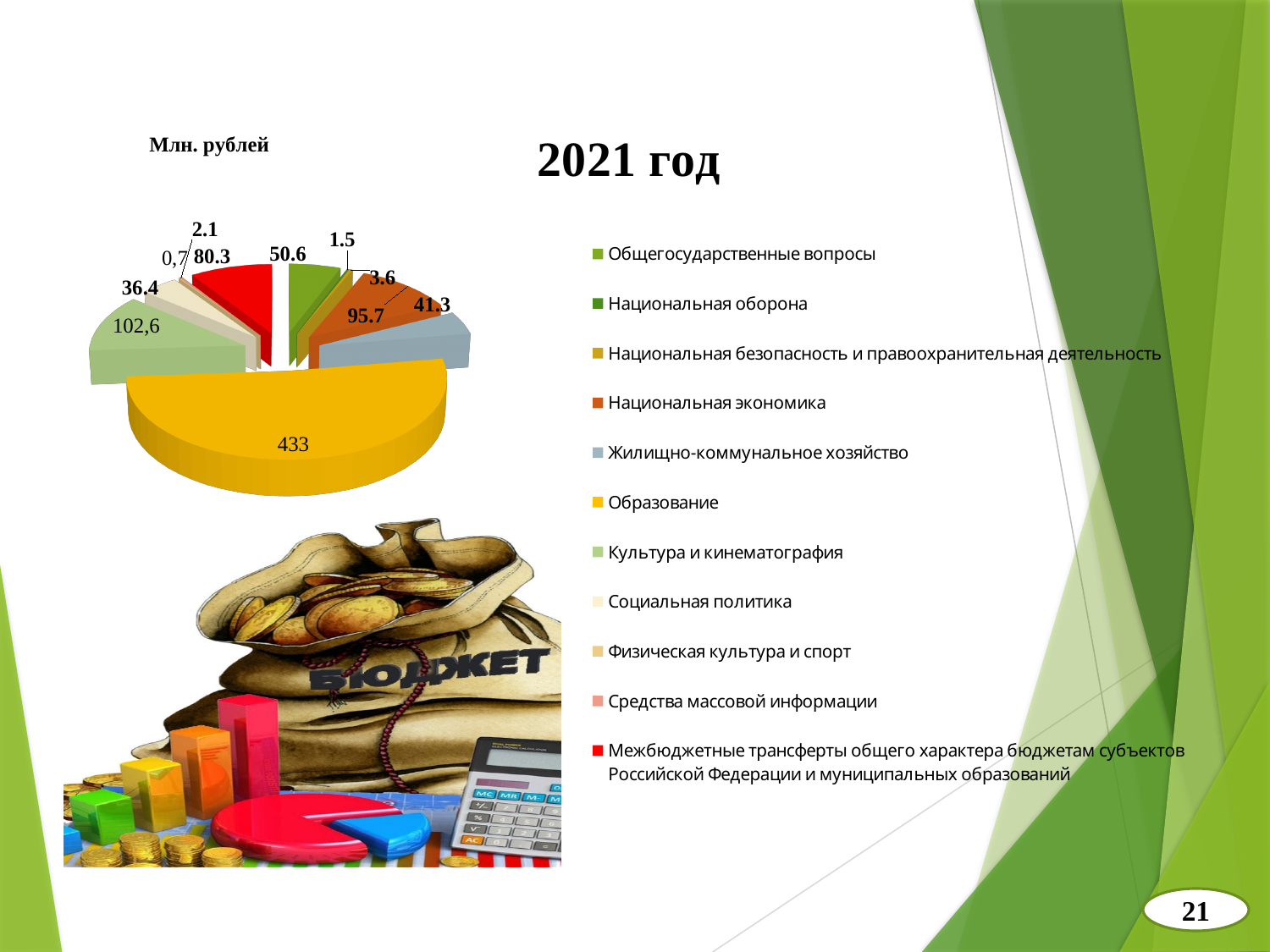
Which category has the largest slice in the pie chart? Образование What year does the slide title refer to? 2021 год Which category has the smallest slice in the pie chart? Физическая культура и спорт Which is larger in the pie chart: Национальная экономика or Жилищно-коммунальное хозяйство? Национальная экономика What is the difference between the values for Образование and Национальная экономика? 337.3 What is the value for Культура и кинематография in the pie chart? 102,6 How many categories does the legend of the pie chart list? 11 In what units are the pie chart values given, according to the label above the chart? Млн. рублей What is the value for Образование in the pie chart? 433 What kind of chart is shown on the slide? pie chart What is the value for Национальная экономика in the pie chart? 95.7 What is the value for Жилищно-коммунальное хозяйство in the pie chart? 41.3